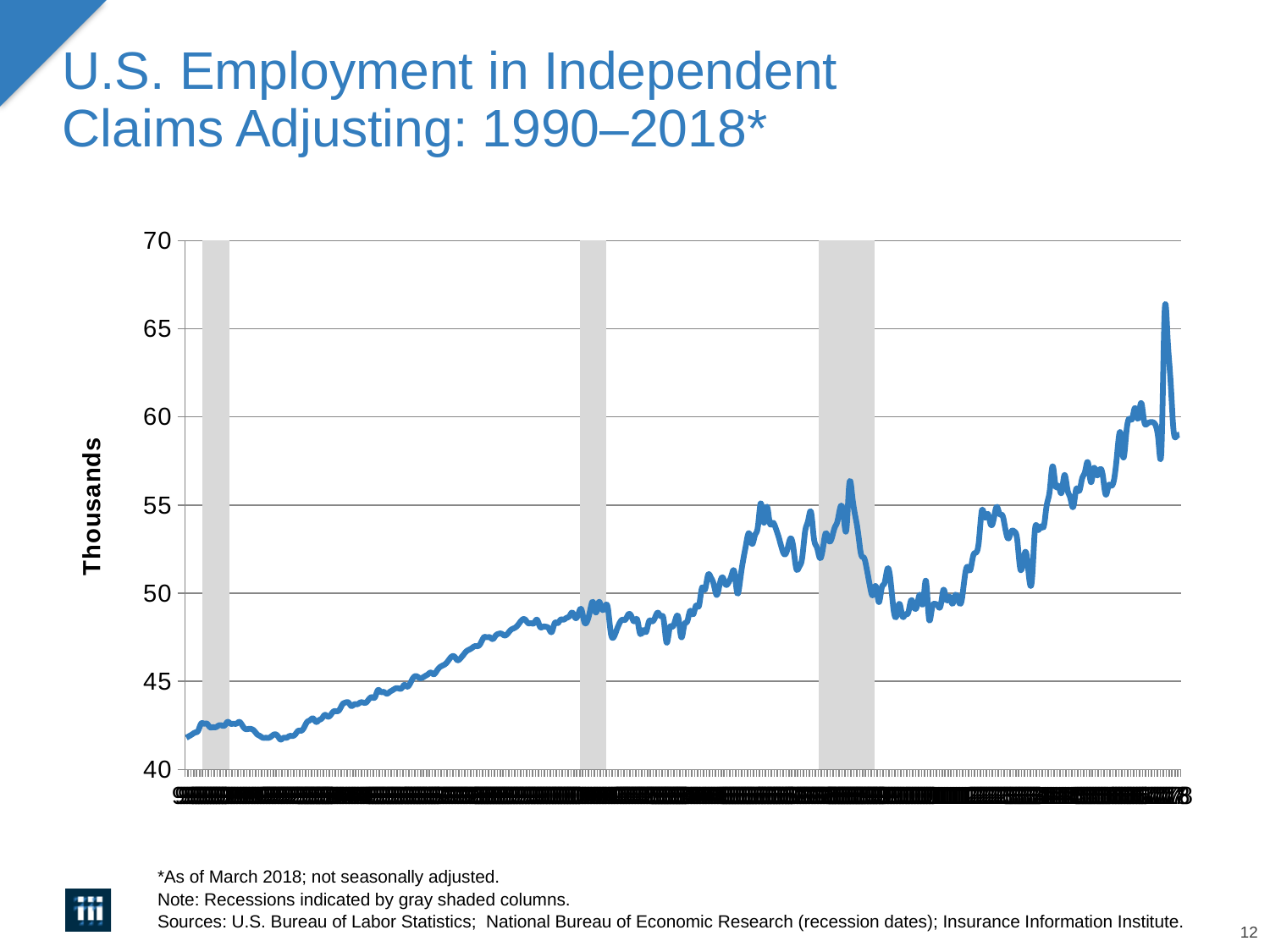
What is the title of the y axis? Thousands Which is larger, the value at the start of the series or the value at the end of the series? the value at the end of the series Is the value at the start of the series (far left) greater or less than 45? less Is the lowest point on the line greater or less than 45? less Overall, do the values rise or fall from the left of the x axis to the right? rise What kind of chart is shown on the slide? line chart Is the value at the end of the series (far right) greater or less than 65? less What is the highest value shown on the y axis? 70